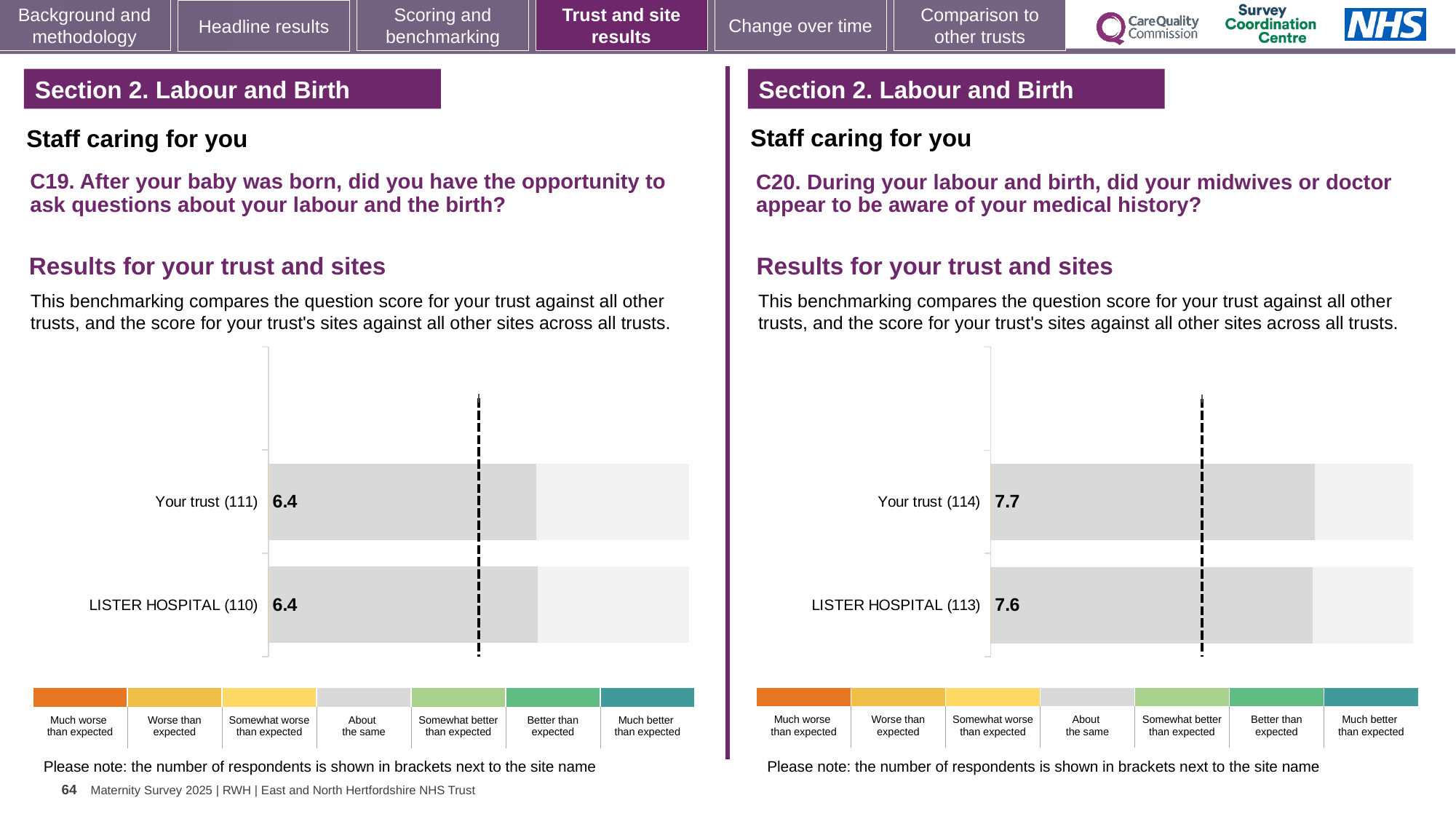
In the C19 chart on the left, what is the score for Your trust (111)? 6.4 What type of chart is used for the C20 results on the right? bar chart In the C20 chart on the right, what is the score for LISTER HOSPITAL (113)? 7.6 In the C20 chart on the right, how many respondents are shown in brackets for LISTER HOSPITAL? 113 In the C19 chart on the left, what is the score for LISTER HOSPITAL (110)? 6.4 In the C20 chart on the right, what is the score for Your trust (114)? 7.7 How many bars are shown in the C20 chart on the right? 2 How many bars are shown in the C19 chart on the left? 2 In the C19 chart on the left, how many respondents are shown in brackets for Your trust? 111 In the C19 chart on the left, is the score for Your trust higher than, lower than, or equal to the score for LISTER HOSPITAL? equal In the C20 chart on the right, which has the higher score, Your trust or LISTER HOSPITAL? Your trust In the C20 chart on the right, what is the difference between the score for Your trust and the score for LISTER HOSPITAL? 0.1